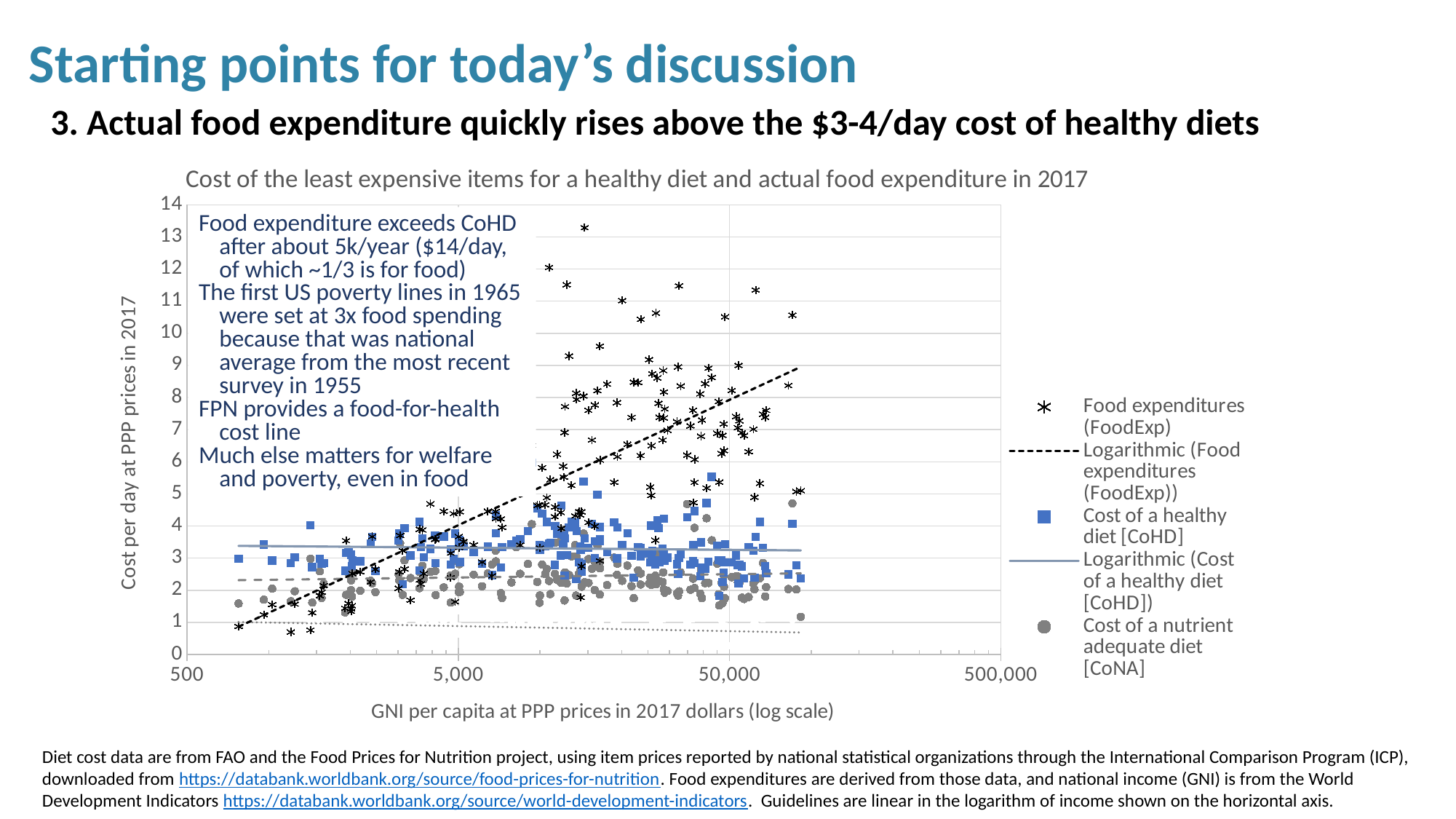
Which marker symbol is used for the Cost of a nutrient adequate diet [CoNA] series? Grey circles What kind of chart is shown on the slide? Scatter chart What is the lowest tick value shown on the horizontal axis of the chart? 500 Is the logarithmic trend line for Cost of a healthy diet [CoHD] greater or less than 4 across the chart? less Do the Food expenditures (FoodExp) points generally rise or fall as GNI per capita increases along the x axis? Rise How many entries does the chart's legend list? 5 At high income levels (around 50,000 GNI per capita), which series has higher values: Food expenditures (FoodExp) or Cost of a healthy diet [CoHD]? Food expenditures (FoodExp) What is the highest value shown on the vertical axis of the chart? 14 What is the title of the chart? Cost of the least expensive items for a healthy diet and actual food expenditure in 2017 Does the dashed logarithmic trend line for Food expenditures rise or fall from left to right? Rise What is the label of the horizontal axis of the chart? GNI per capita at PPP prices in 2017 dollars (log scale) Is the highest Food expenditures (FoodExp) point on the chart greater or less than 12? greater